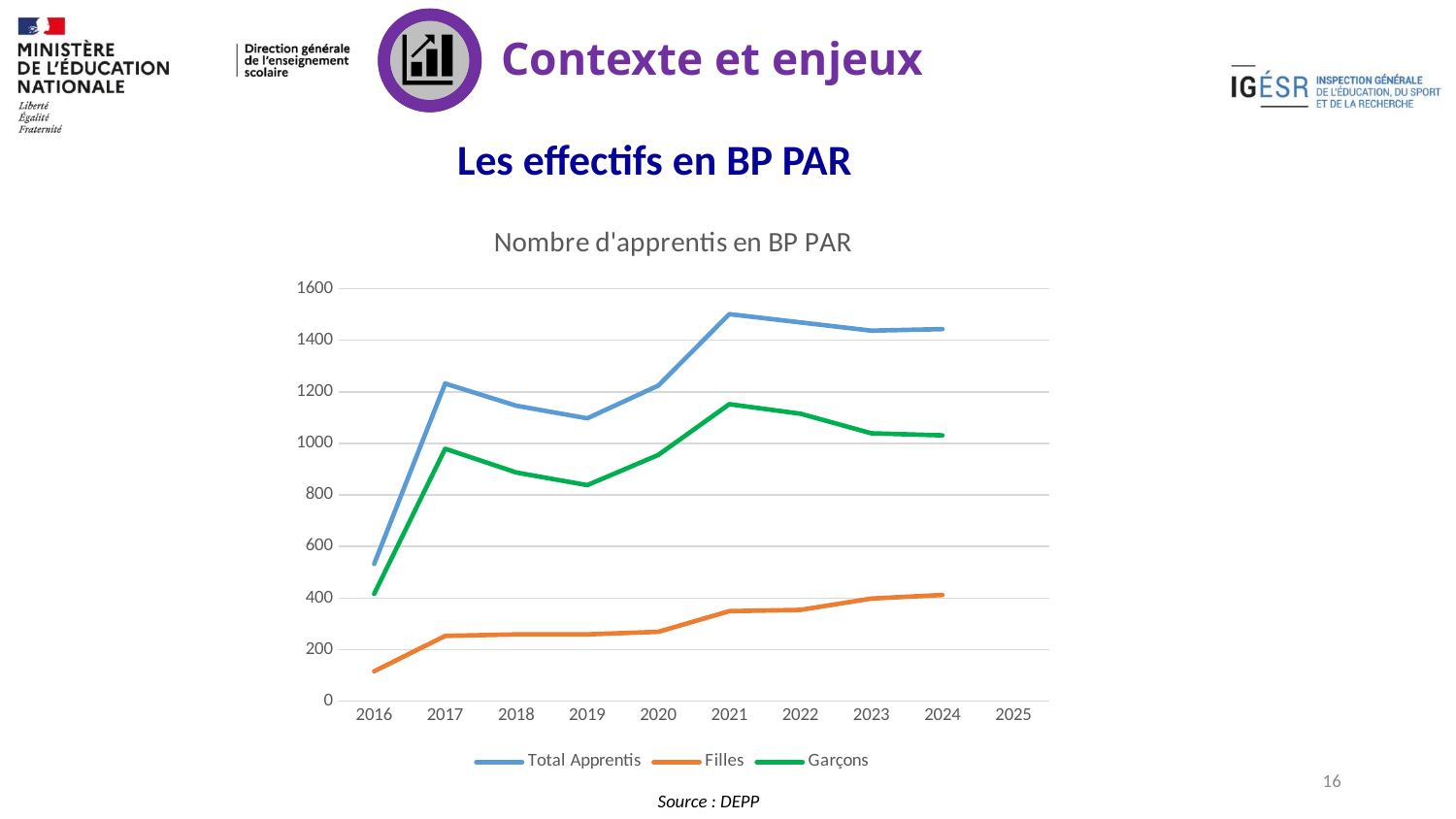
In which year is the Total Apprentis value highest? 2021 What is the title of the chart? Nombre d'apprentis en BP PAR In which year is the Total Apprentis value lowest? 2016 Is the Garçons value for 2019 greater or less than 1000? less How many series does the legend list? 3 Does the Filles series rise or fall overall from 2016 to 2024? rise Is the Filles value for 2016 greater or less than 200? less What are the three series named in the legend? Total Apprentis, Filles, Garçons What kind of chart is shown on the slide? line chart In which year is the Garçons value highest? 2021 In 2024, which series has the larger value, Garçons or Filles? Garçons Is the Total Apprentis value for 2021 greater or less than 1400? greater